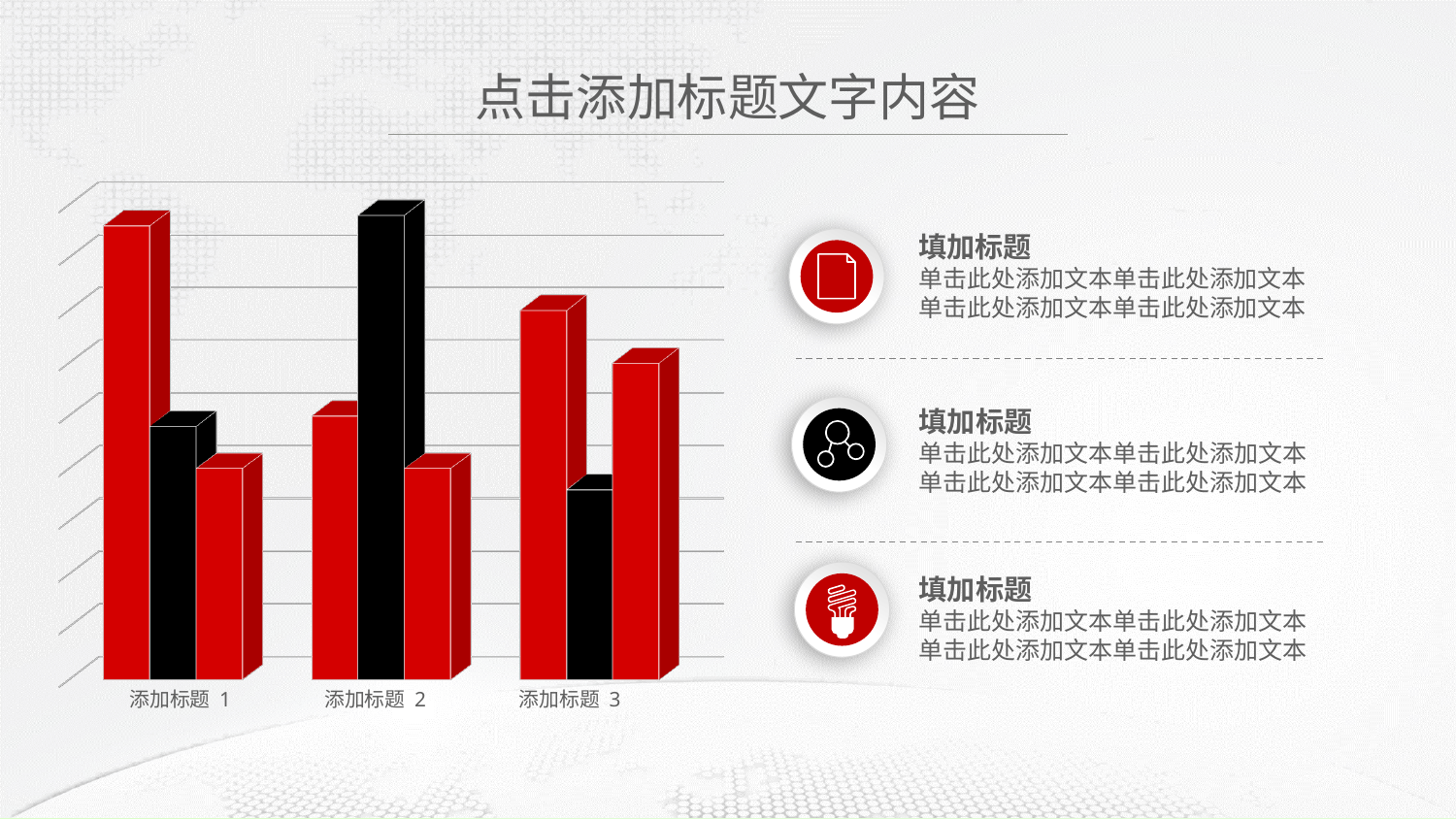
Is the black bar for 添加标题 3 taller or shorter than the black bar for 添加标题 1? Shorter In the category 添加标题 1, which bar is the tallest? The first (red) bar Is the black bar for 添加标题 1 taller or shorter than the black bar for 添加标题 2? Shorter Is the first red bar for 添加标题 3 taller or shorter than the first red bar for 添加标题 2? Taller What kind of chart is shown on the slide? Bar chart In the category 添加标题 2, which bar is the tallest? The middle (black) bar How many bars are plotted for each category in the chart? 3 Which category contains the tallest bar in the chart? 添加标题 2 In the category 添加标题 2, which bar is the shortest? The third (red) bar How many categories are shown on the x axis of the chart? 3 In the category 添加标题 3, which bar is the shortest? The middle (black) bar What two colours are used for the bars in the chart? Red and black